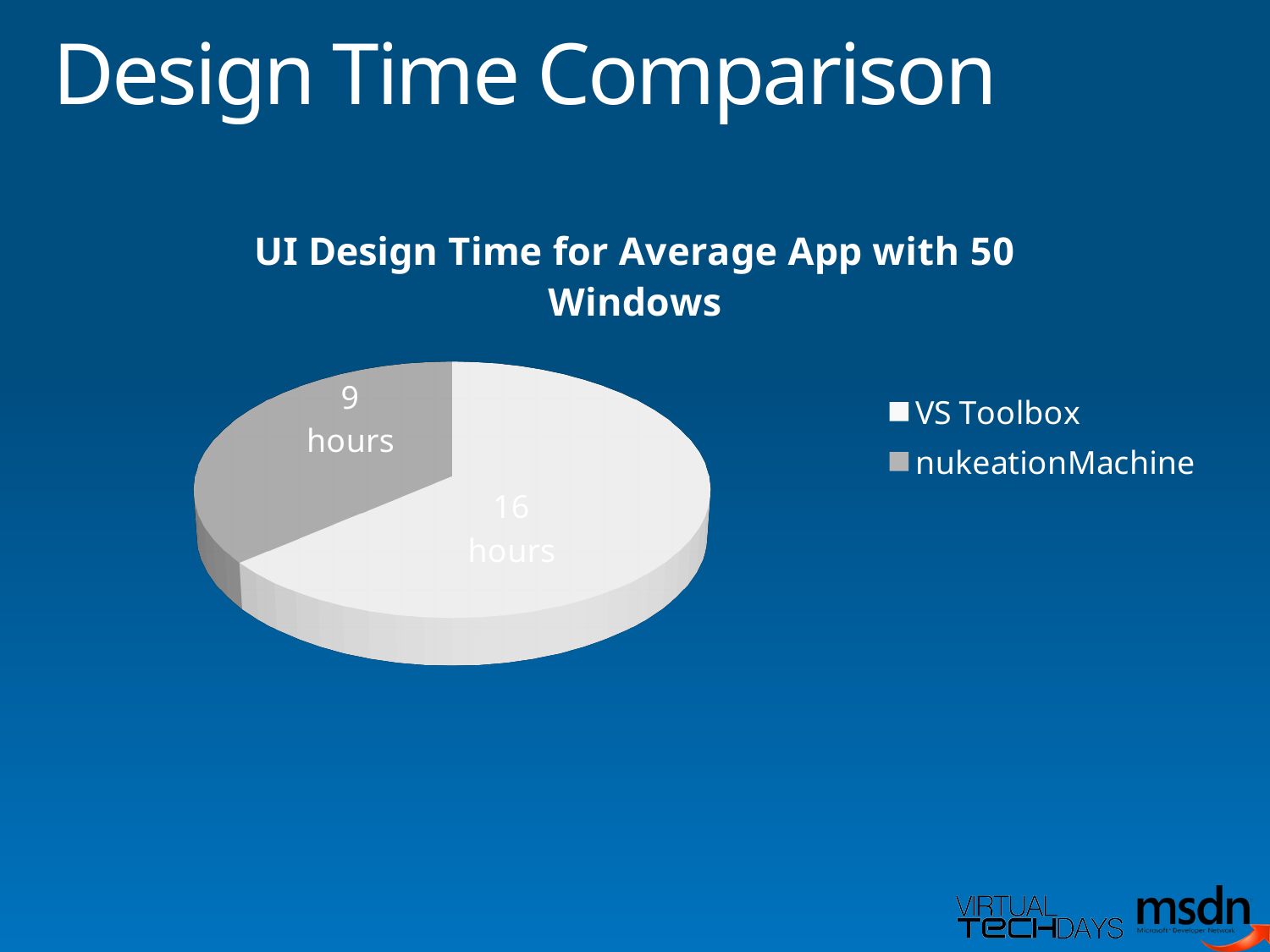
Which category has the largest slice of the pie? VS Toolbox What kind of chart is shown on the slide? Pie chart What is the difference in hours between VS Toolbox and nukeationMachine? 7 hours What is the UI design time for nukeationMachine? 9 hours What is the UI design time for VS Toolbox? 16 hours How many slices does the pie chart have? 2 What is the title of the chart? UI Design Time for Average App with 50 Windows Which takes more design time, VS Toolbox or nukeationMachine? VS Toolbox Which category has the smallest slice of the pie? nukeationMachine How many entries does the legend list? 2 What share of the pie does the nukeationMachine slice represent? 36% What is the total number of hours represented in the pie chart? 25 hours